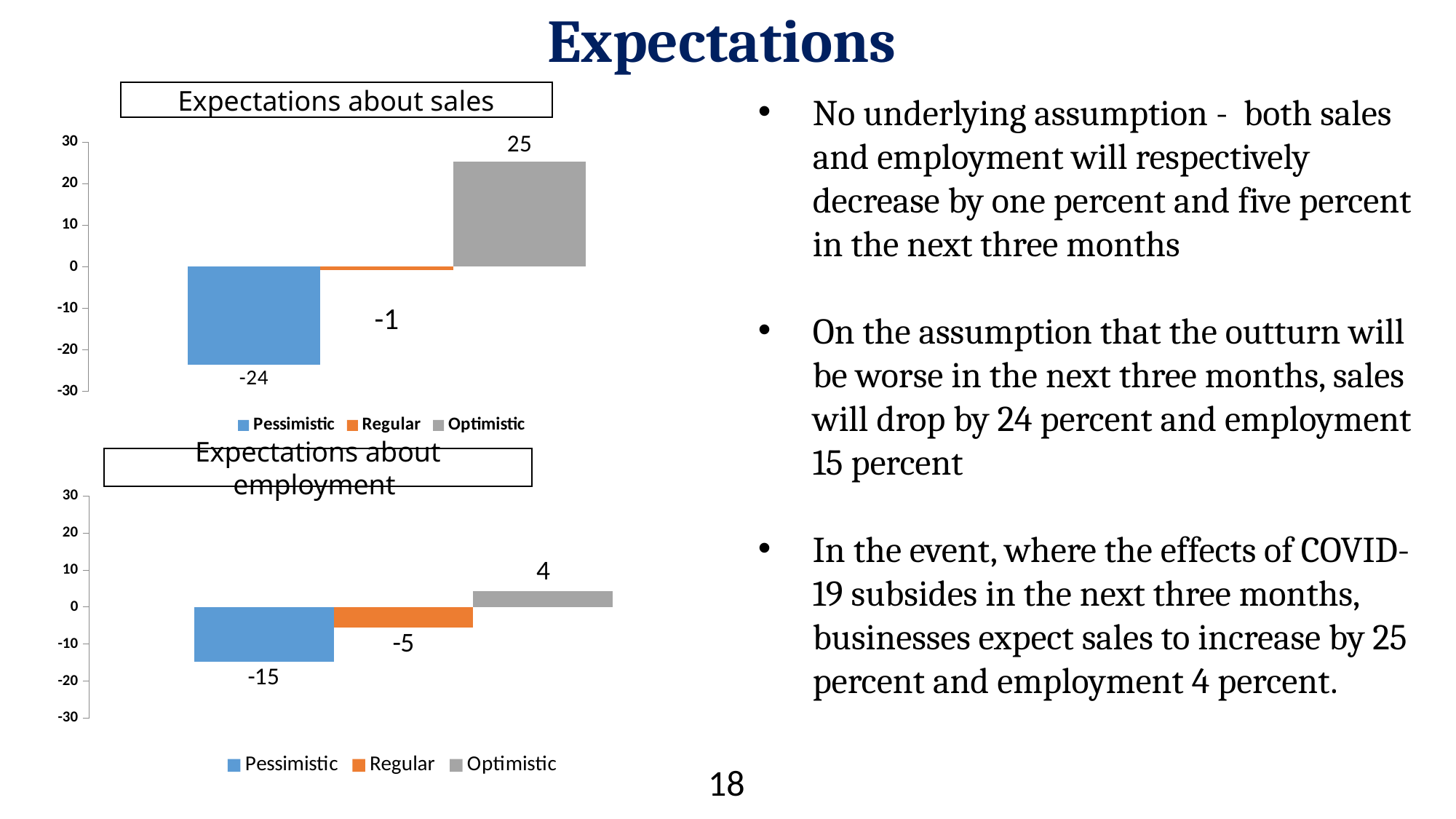
In the 'Expectations about employment' chart, what is the value for Pessimistic? -15 In the 'Expectations about sales' chart, what is the value for Optimistic? 25 In the 'Expectations about employment' chart, what is the value for Regular? -5 In the 'Expectations about employment' chart, what is the difference between the Optimistic and Pessimistic values? 19 How many series does the legend of the 'Expectations about employment' chart list? 3 In the 'Expectations about sales' chart, what is the value for Regular? -1 In the 'Expectations about sales' chart, which series has the highest value? Optimistic In the 'Expectations about employment' chart, which series has the lowest value? Pessimistic In the 'Expectations about employment' chart, what is the value for Optimistic? 4 In the 'Expectations about sales' chart, what is the difference between the Optimistic and Pessimistic values? 49 In the 'Expectations about sales' chart, what is the value for Pessimistic? -24 What type of chart is the 'Expectations about sales' chart? Bar chart